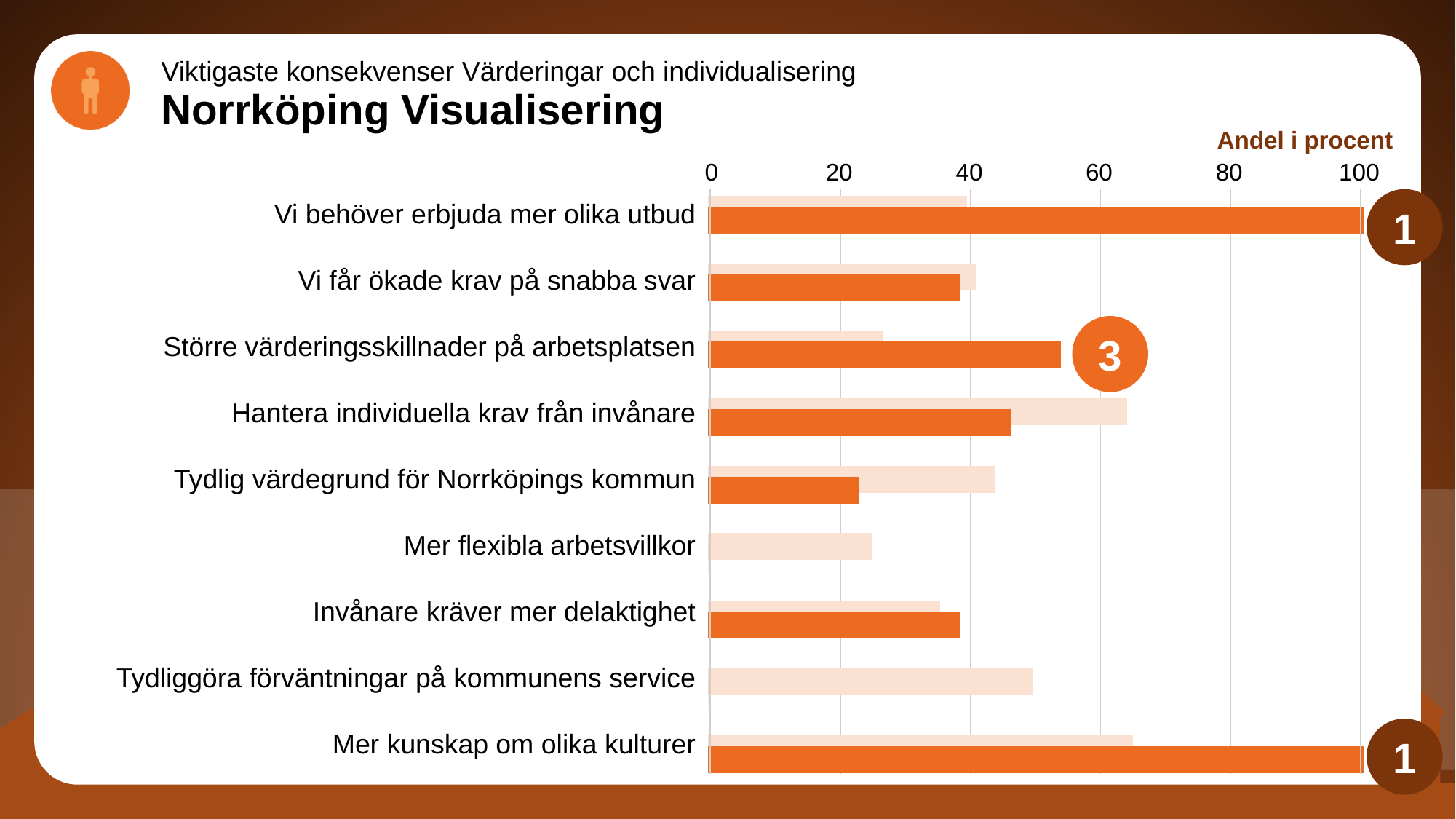
Is the dark orange bar for "Större värderingsskillnader på arbetsplatsen" greater or less than 40? greater How many categories are listed on the chart? 9 Is the light orange bar for "Mer flexibla arbetsvillkor" greater or less than 40? less What is the value of the dark orange bar for "Mer kunskap om olika kulturer"? 100 Which has the larger light orange bar: "Hantera individuella krav från invånare" or "Tydlig värdegrund för Norrköpings kommun"? Hantera individuella krav från invånare Is the light orange bar for "Hantera individuella krav från invånare" greater or less than 60? greater What label is shown above the horizontal axis of the chart? Andel i procent What is the bold title of the slide? Norrköping Visualisering What kind of chart is shown on the slide? bar chart Which has the larger dark orange bar: "Större värderingsskillnader på arbetsplatsen" or "Vi får ökade krav på snabba svar"? Större värderingsskillnader på arbetsplatsen What is the value of the dark orange bar for "Vi behöver erbjuda mer olika utbud"? 100